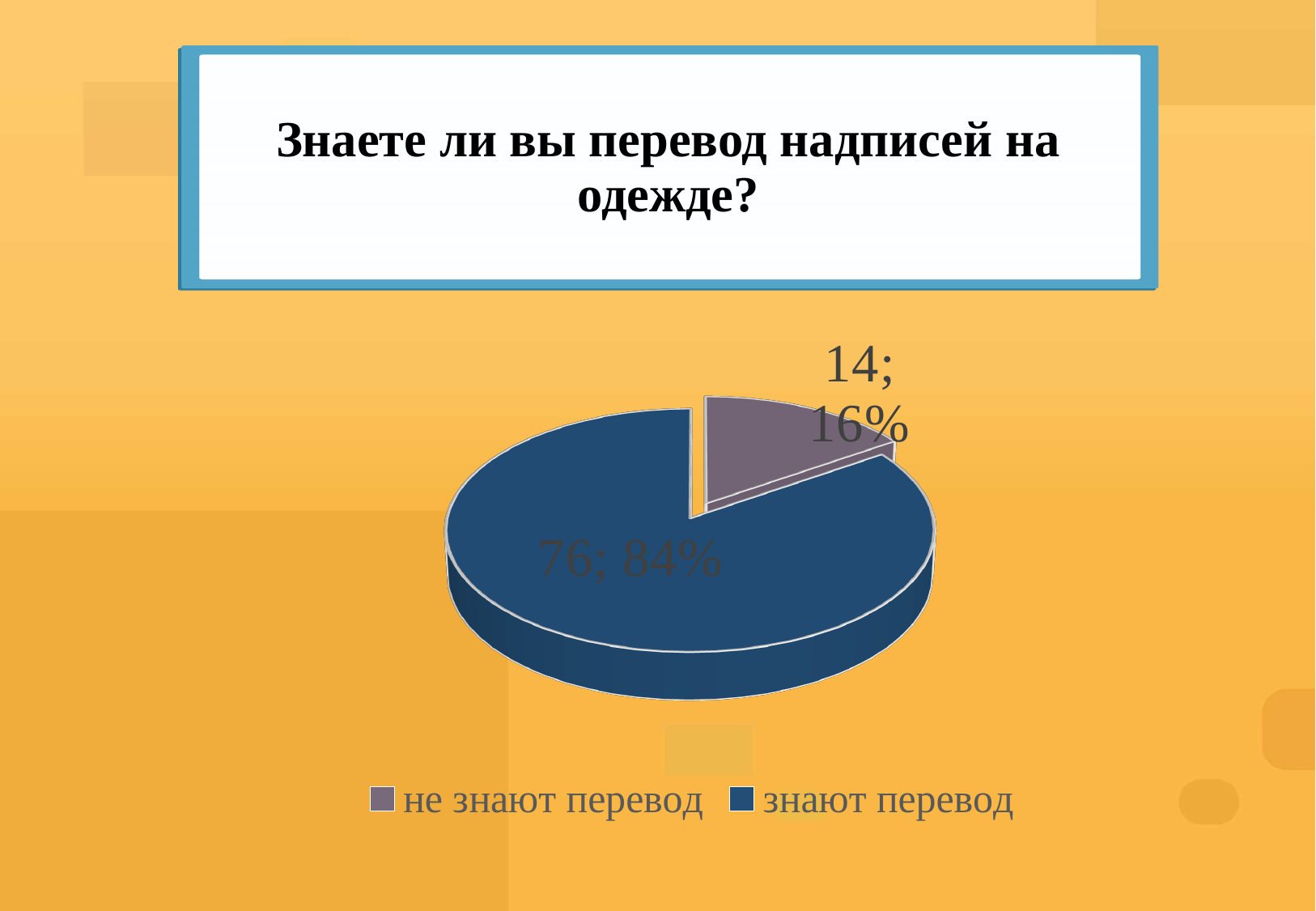
What is the difference between the values for "знают перевод" and "не знают перевод"? 62 What share of the pie does "не знают перевод" represent? 16% Which category has the largest slice? знают перевод How many slices does the pie chart have? 2 What is the value for "не знают перевод"? 14 What is the total of the two values shown on the pie chart? 90 What colour is the slice for "не знают перевод"? purple-grey How many entries does the legend list? 2 Which category has the smallest slice? не знают перевод What share of the pie does "знают перевод" represent? 84% What is the value for "знают перевод"? 76 What kind of chart is shown on the slide? pie chart